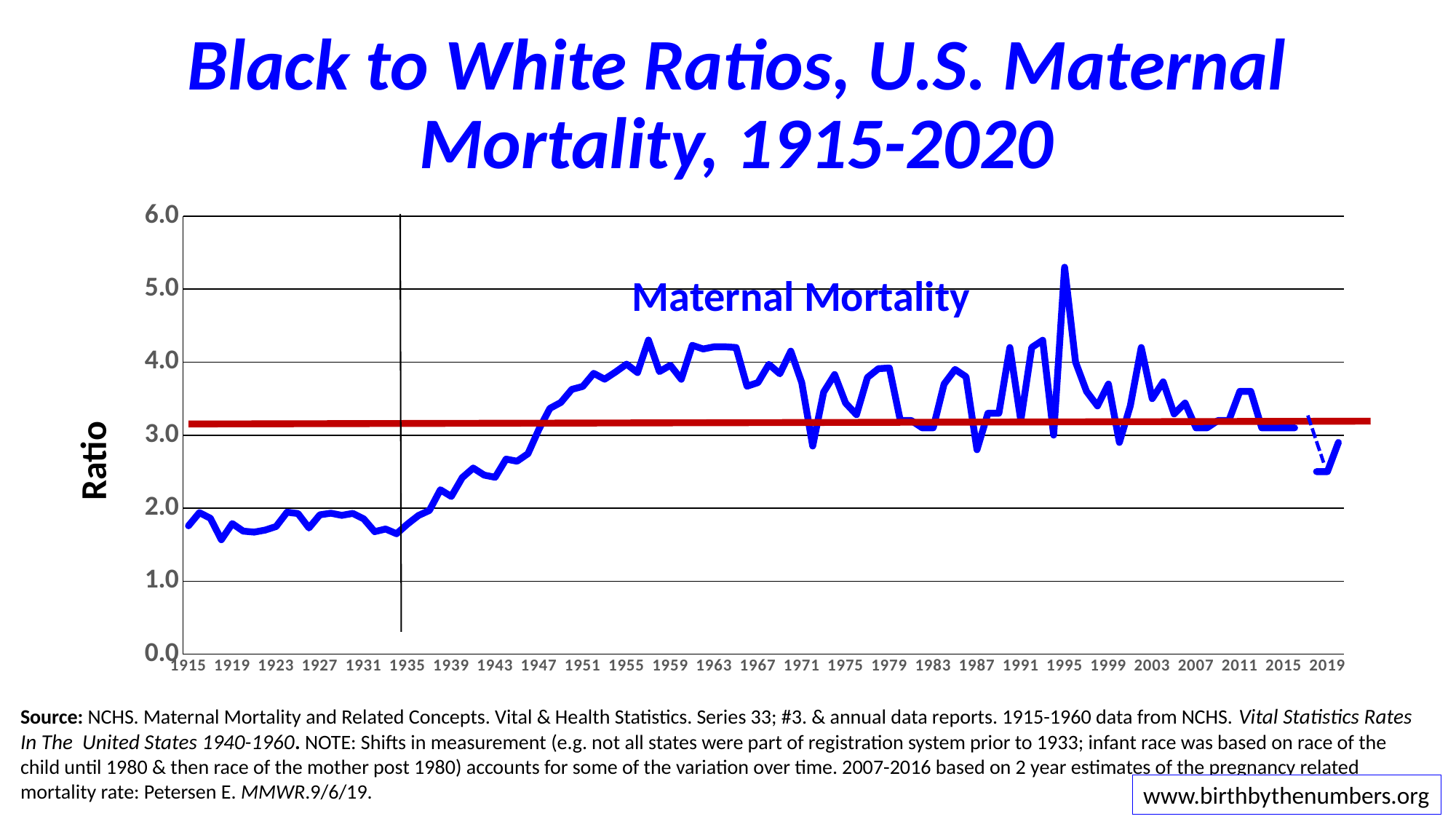
Is the Maternal Mortality ratio in 1915 greater or less than 2.0? less Does the Maternal Mortality ratio rise or fall between 1935 and 1955? rise Which year has the larger Maternal Mortality ratio, 1915 or 1995? 1995 Is the Maternal Mortality ratio in 2019 greater or less than 3.0? less What is the title of the chart on the slide? Black to White Ratios, U.S. Maternal Mortality, 1915-2020 What is the highest value shown on the vertical axis of the chart? 6.0 In which year does the Maternal Mortality ratio reach its highest value? 1995 Is the Maternal Mortality ratio in 1995 greater or less than 5.0? greater What is the label on the vertical axis of the chart? Ratio What kind of chart is shown on the slide? line chart